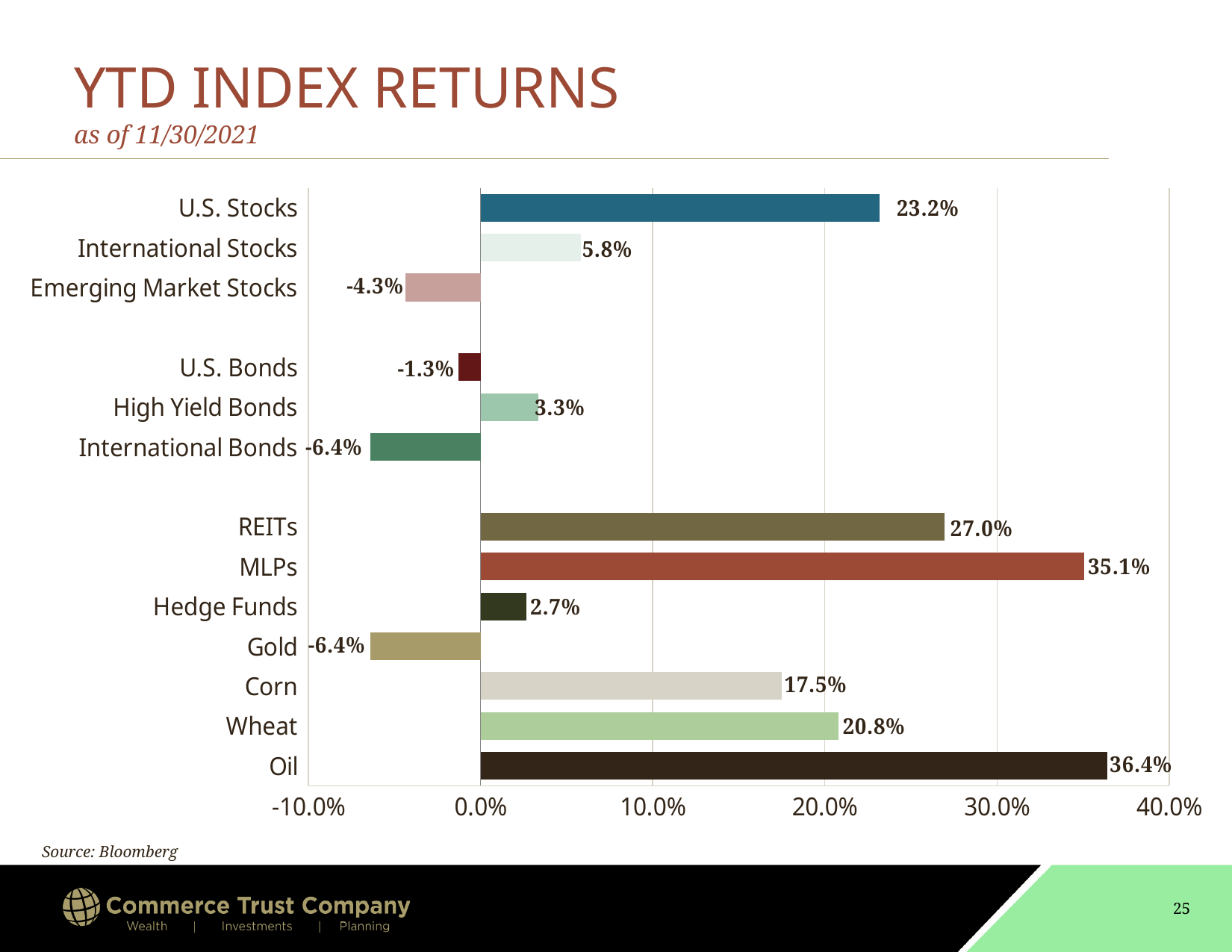
Which of the three stock indexes has the lowest YTD return? Emerging Market Stocks Which index has the highest YTD return? Oil What is the YTD return for Corn? 17.5% How many indexes are shown in the chart? 13 What kind of chart is shown on the slide? Bar chart What is the YTD return for U.S. Stocks? 23.2% What is the YTD return for MLPs? 35.1% What is the difference between the YTD returns of Oil and MLPs? 1.3 percentage points What is the difference between the YTD returns of Wheat and Corn? 3.3 percentage points Is the value for Wheat greater or less than 30.0%? less Which has a higher YTD return, REITs or U.S. Stocks? REITs What is the YTD return for Emerging Market Stocks? -4.3%